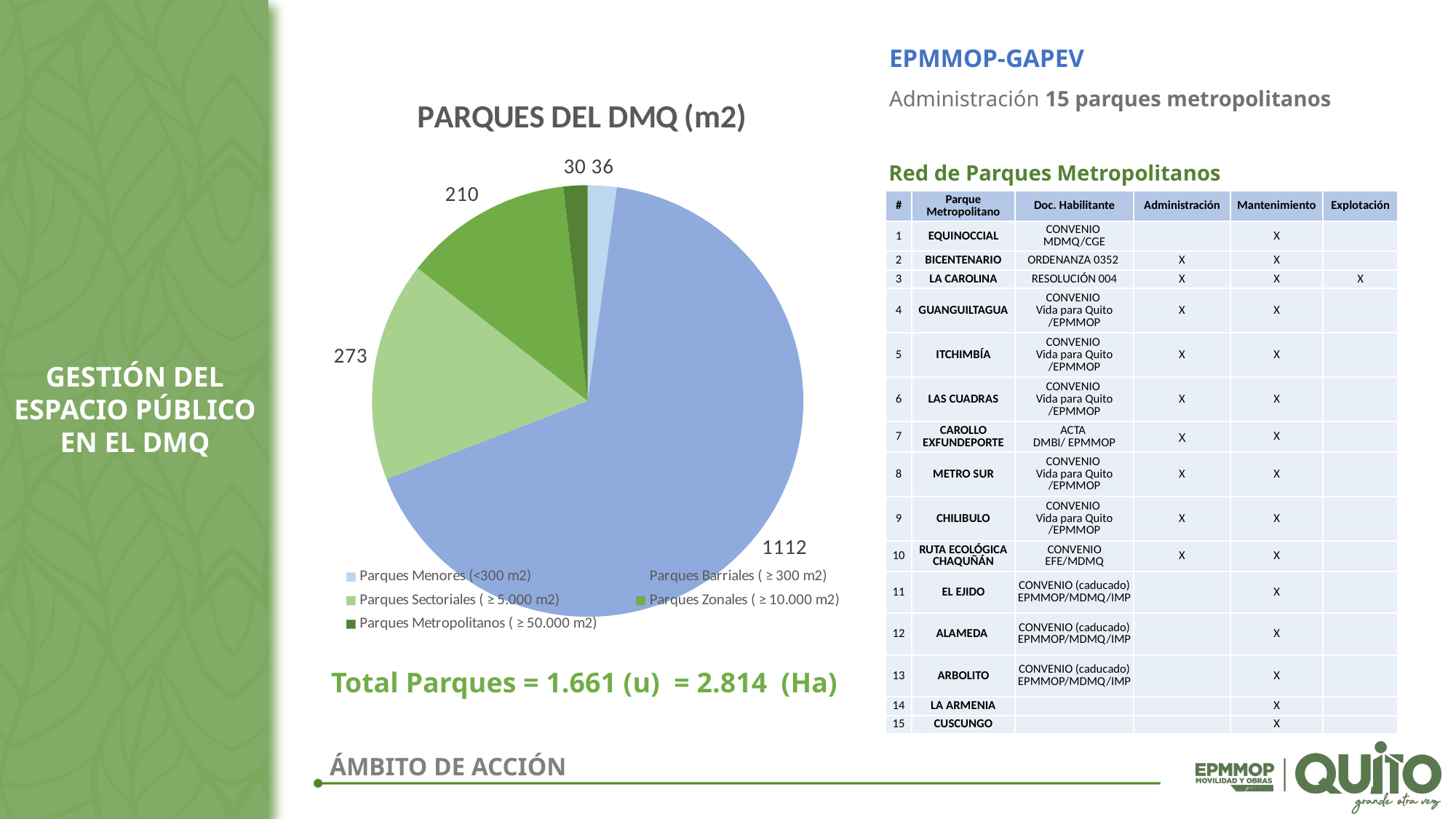
What is the value for Parques Barriales ( ≥ 300 m2)? 1112 What is the difference between the values for Parques Barriales and Parques Sectoriales? 839 What is the value for Parques Menores (<300 m2)? 36 What is the value for Parques Metropolitanos ( ≥ 50.000 m2)? 30 What is the title of the chart? PARQUES DEL DMQ (m2) Which category has the smallest slice of the pie? Parques Metropolitanos ( ≥ 50.000 m2) Which category has the largest slice of the pie? Parques Barriales ( ≥ 300 m2) What type of chart is shown on the slide? pie chart Which is larger, the value for Parques Sectoriales or Parques Zonales? Parques Sectoriales What is the value for Parques Zonales ( ≥ 10.000 m2)? 210 How many slices does the pie chart have? 5 What is the value for Parques Sectoriales ( ≥ 5.000 m2)? 273